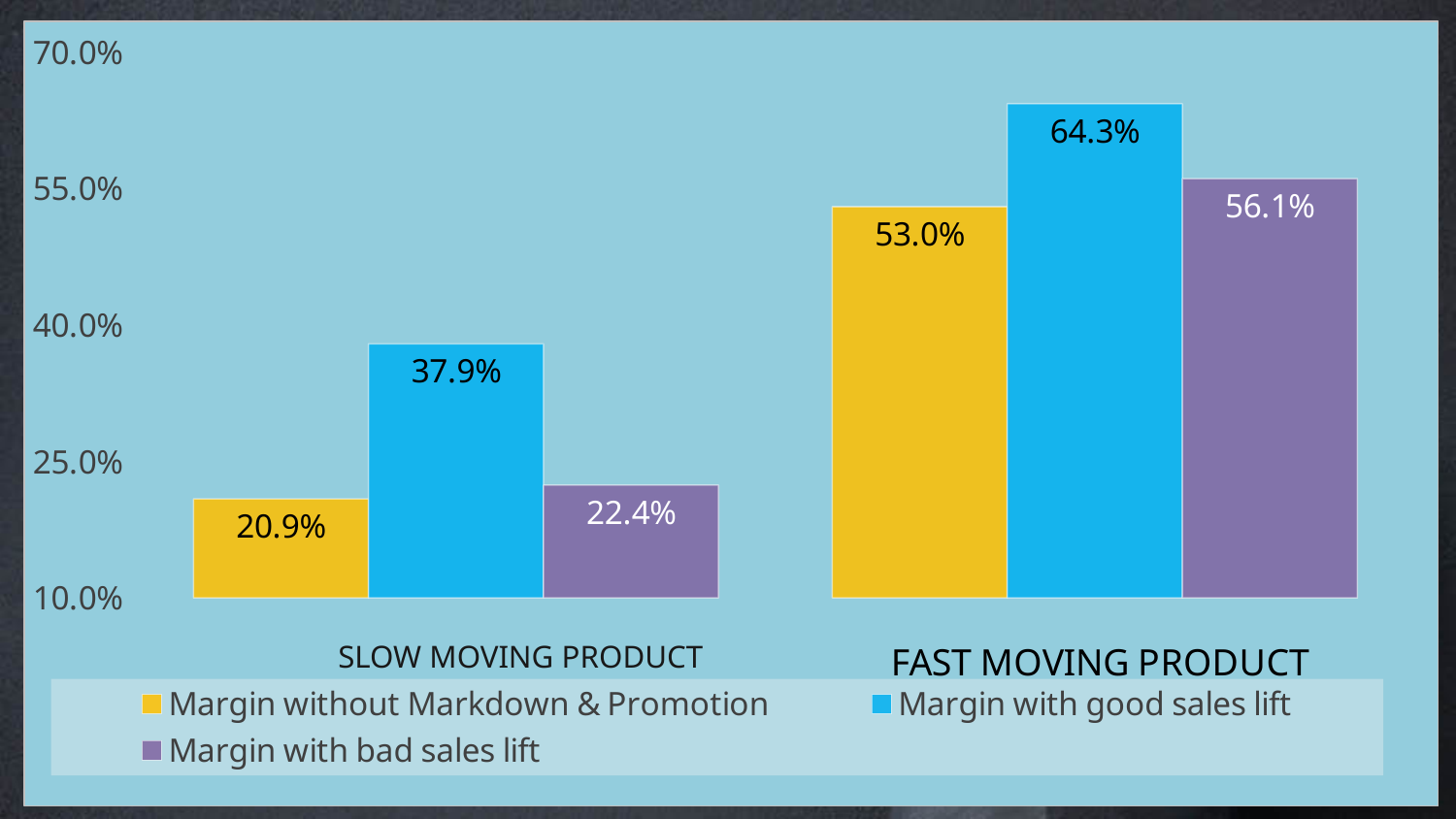
Which series has the lowest value for Slow Moving Product? Margin without Markdown & Promotion What is the Margin without Markdown & Promotion for Fast Moving Product? 53.0% What is the difference between the Margin with good sales lift and the Margin without Markdown & Promotion for Fast Moving Product? 11.3% Which series has the highest value for Fast Moving Product? Margin with good sales lift What is the difference between the Margin with good sales lift for Fast Moving Product and for Slow Moving Product? 26.4% How many series does the legend list? 3 What is the Margin with good sales lift for Slow Moving Product? 37.9% What is the Margin with bad sales lift for Slow Moving Product? 22.4% What is the Margin with bad sales lift for Fast Moving Product? 56.1% Which is larger: the Margin with bad sales lift for Fast Moving Product or the Margin without Markdown & Promotion for Fast Moving Product? Margin with bad sales lift What kind of chart is shown on the slide? Bar chart How many product categories are shown on the x axis? 2